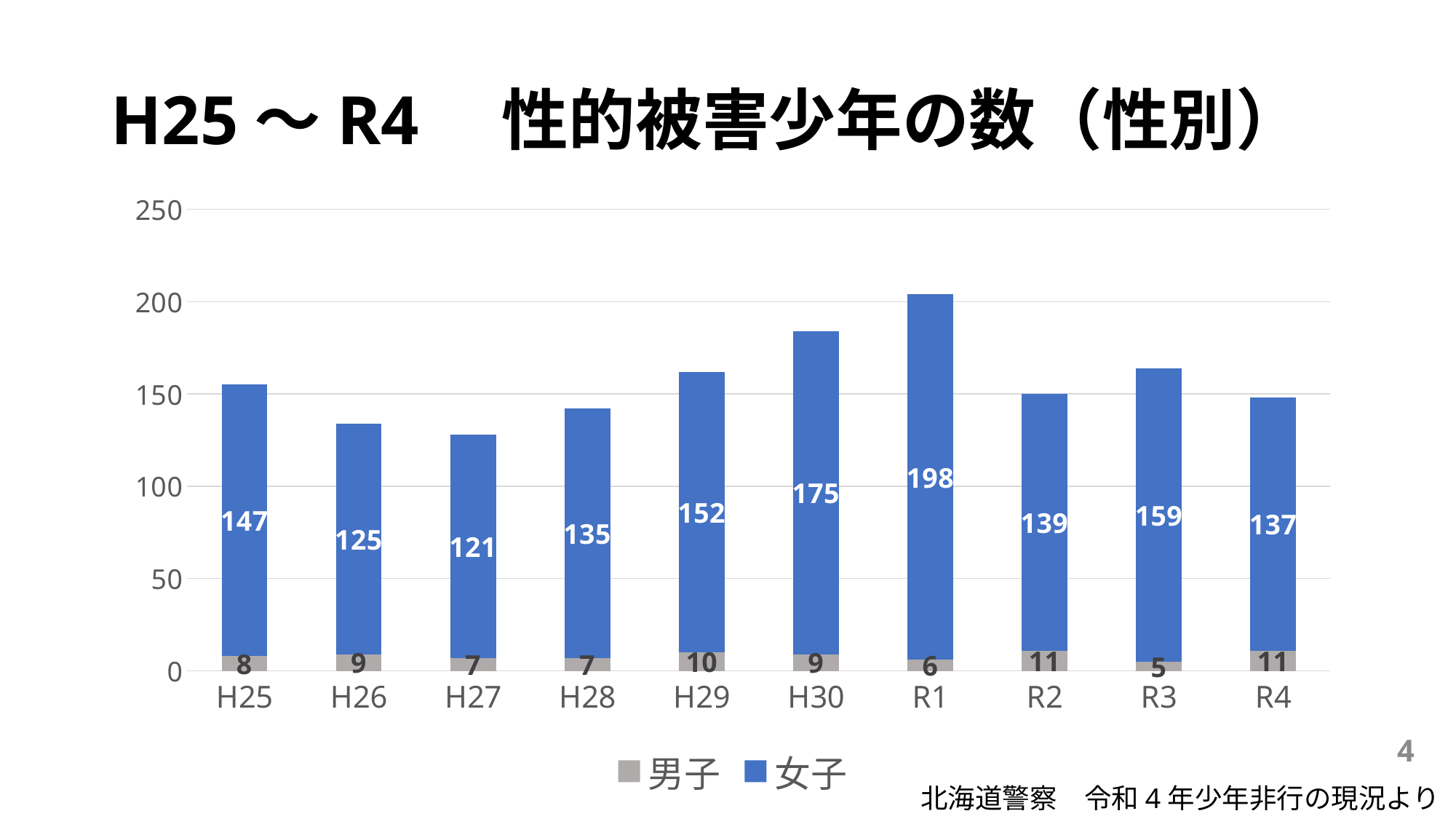
What is the total of the stacked bar for H25? 155 How many years are shown on the x axis? 10 What kind of chart is shown on the slide? Stacked bar chart What is the value for 女子 in H27? 121 What is the value for 女子 in R1? 198 What is the value for 男子 in H29? 10 Which year has the highest value for 女子? R1 Which is larger, the 女子 value for R3 or for R2? R3 What is the difference between the 女子 values for H30 and H29? 23 How many series does the legend list? 2 What is the total of the stacked bar for R1? 204 Which year has the lowest value for 男子? R3